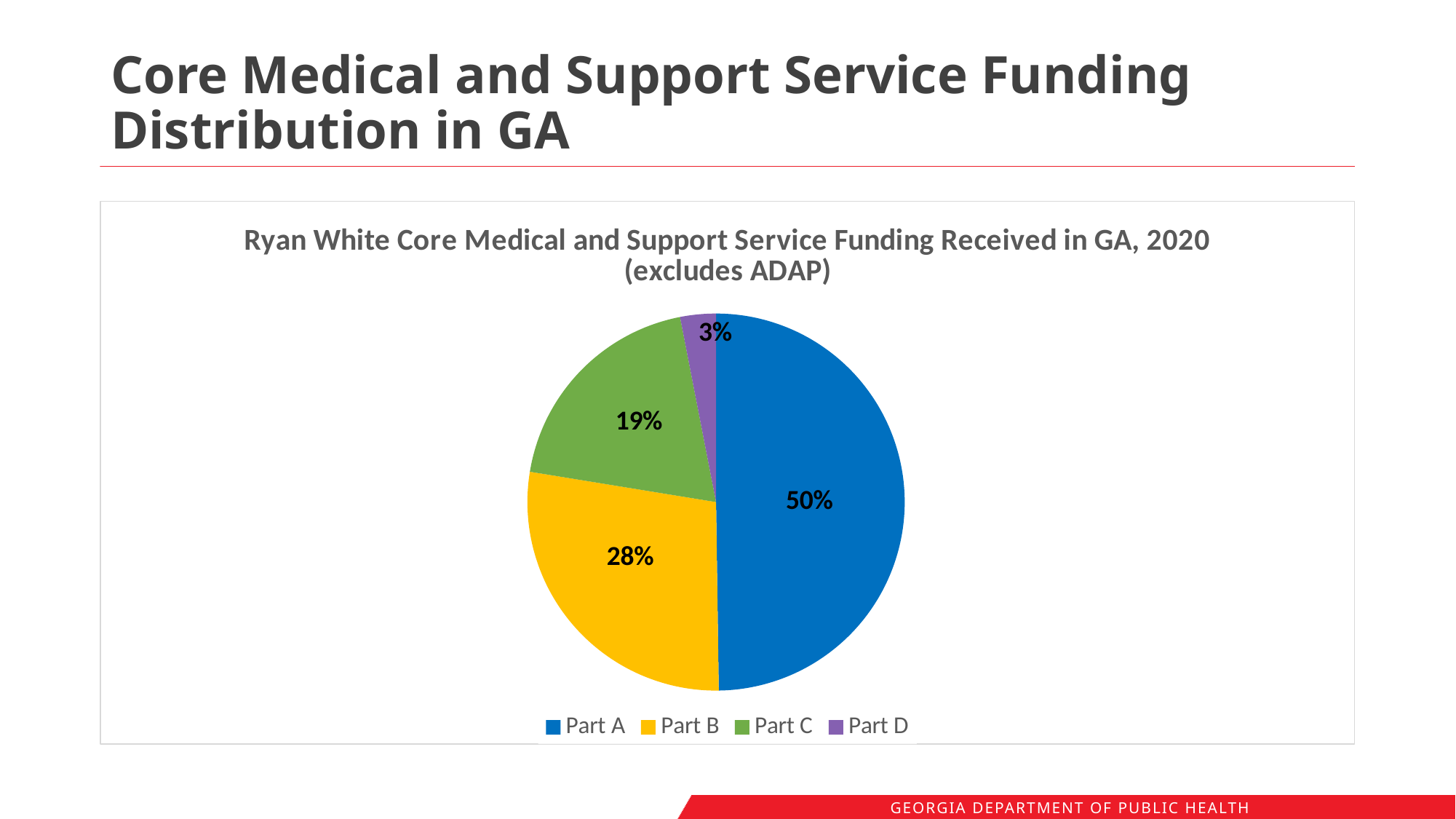
What is the difference in percentage points between Part C and Part D? 16 What share of the pie does Part A represent? 50% Which is larger, the share for Part B or the share for Part C? Part B What type of chart is shown on the slide? Pie chart What is the difference in percentage points between Part A and Part B? 22 Which part received the largest share of funding? Part A How many slices does the pie chart have? 4 What is the title of the chart? Ryan White Core Medical and Support Service Funding Received in GA, 2020 (excludes ADAP) What share of the pie does Part D represent? 3% What share of the pie does Part B represent? 28% Which part received the smallest share of funding? Part D